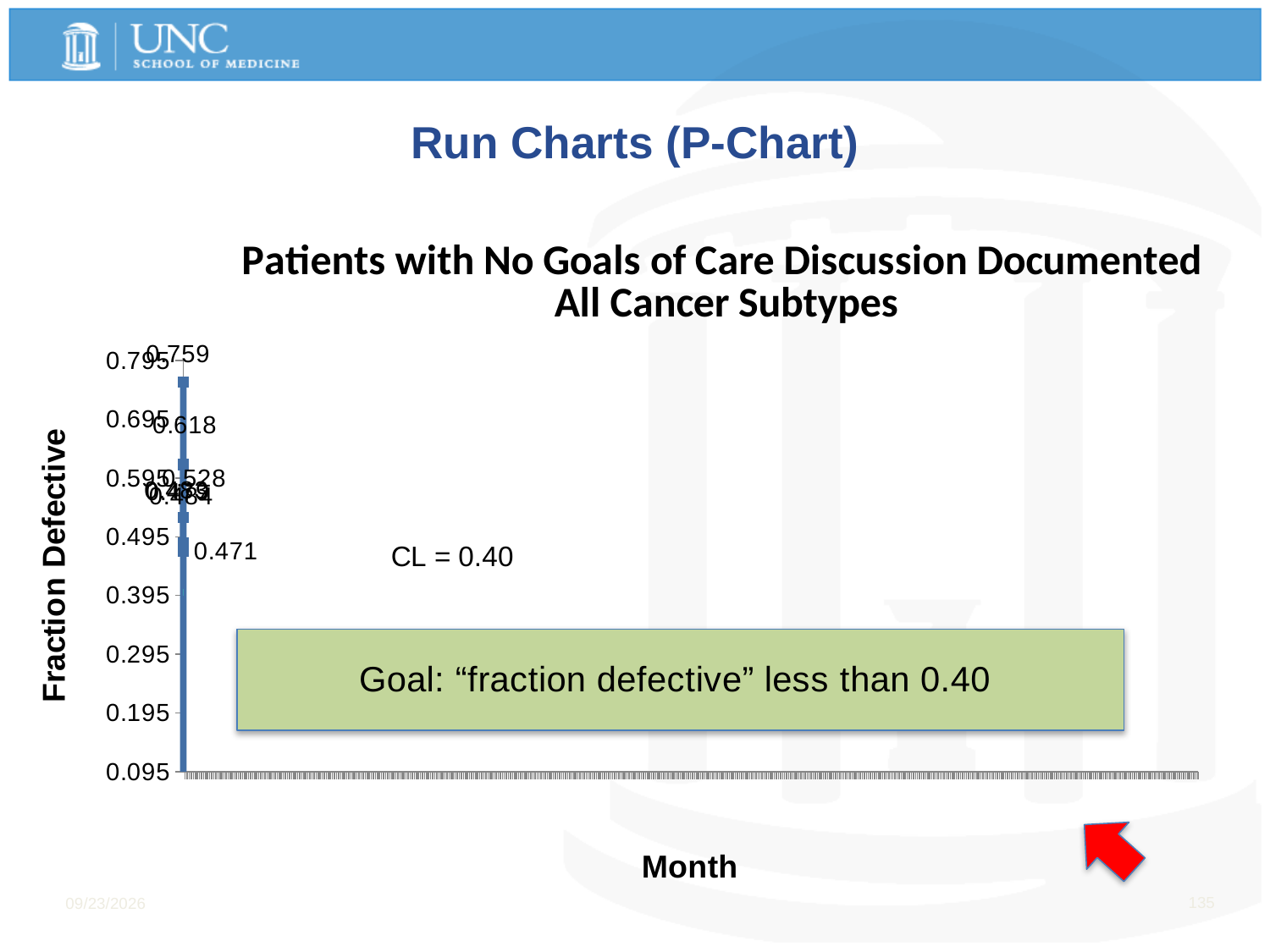
Which is larger: the data label 0.618 or the data label 0.528? 0.618 What is the largest value printed as a data label on the chart? 0.759 Is the highest labelled data point on the chart greater or less than 0.695? greater What is the title of the chart on the slide? Patients with No Goals of Care Discussion Documented All Cancer Subtypes Is the data point labelled 0.471 greater or less than the centre line value CL = 0.40? greater What is the label on the vertical axis of the chart? Fraction Defective What is the difference between the data labels 0.759 and 0.471? 0.288